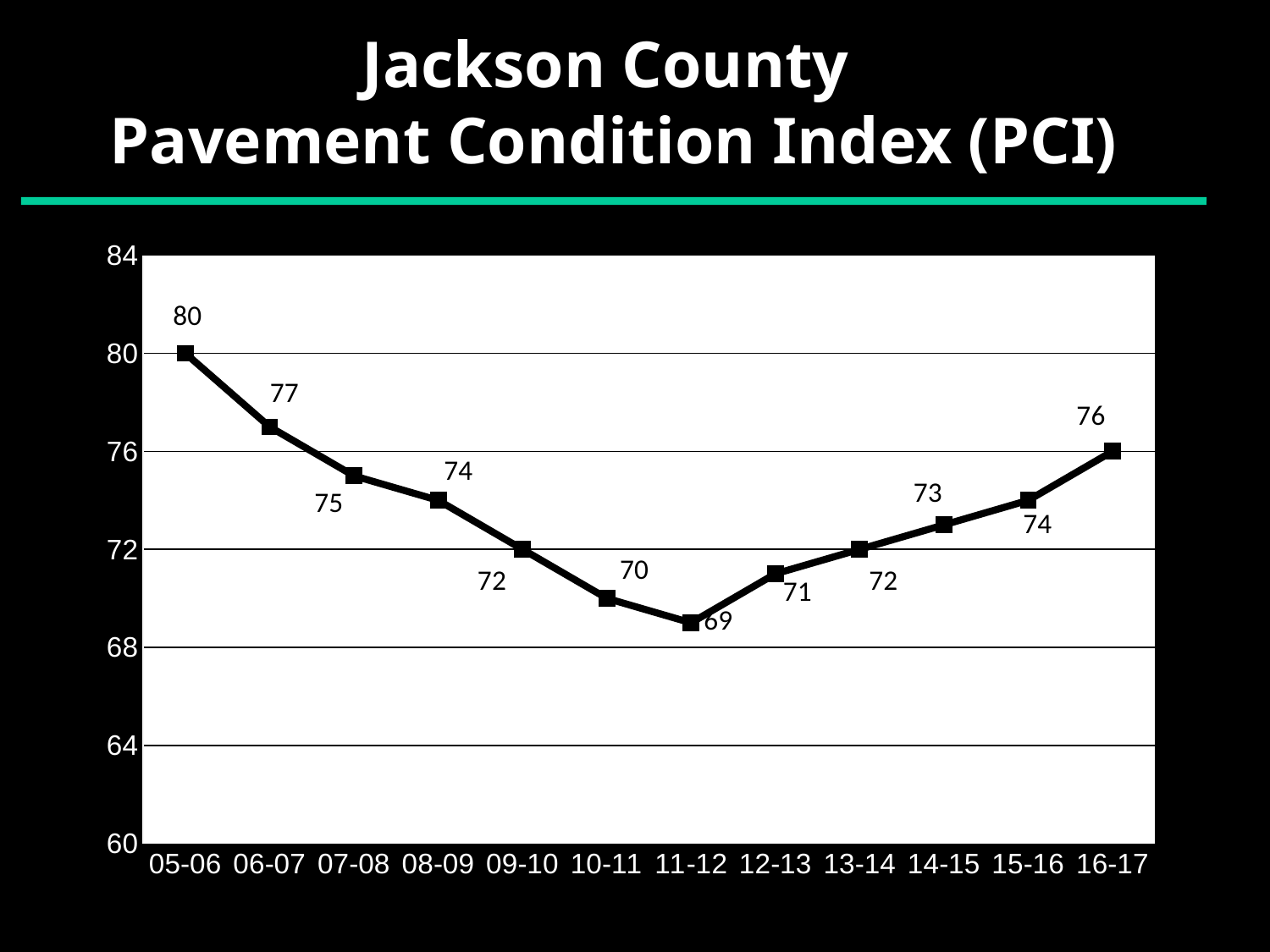
What is the PCI value for 11-12? 69 Which year has the highest PCI value? 05-06 What is the PCI value for 05-06? 80 Which is larger, the PCI value for 06-07 or for 16-17? 06-07 What is the PCI value for 16-17? 76 Which year has the lowest PCI value? 11-12 Do the PCI values rise or fall from 11-12 to 16-17? rise What is the difference between the PCI values for 05-06 and 11-12? 11 What kind of chart is shown on the slide? line chart How many years are plotted on the x axis? 12 What is the PCI value for 14-15? 73 Is the PCI value for 10-11 greater or less than 72? less